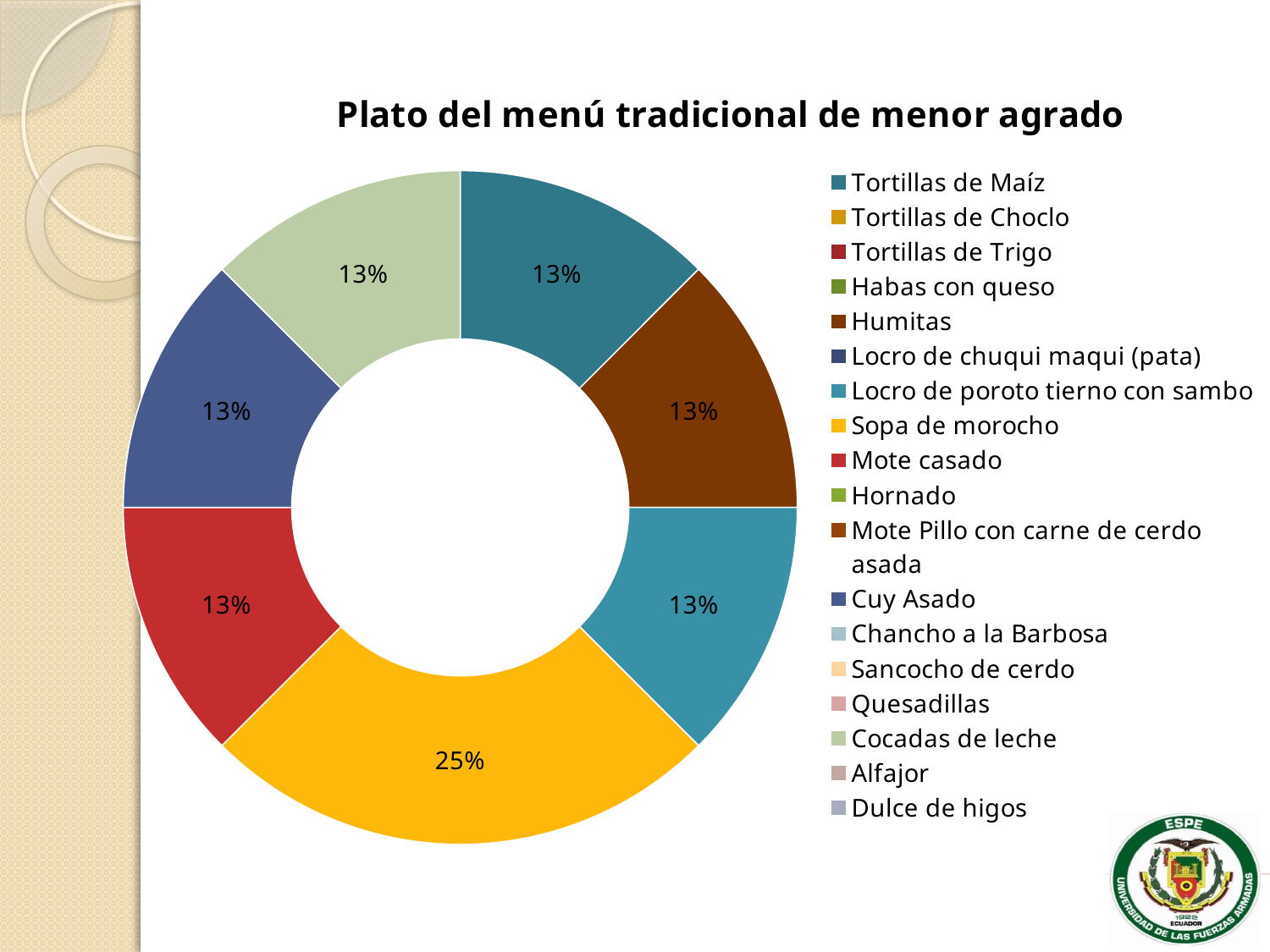
What percentage is shown for Cocadas de leche? 13% What is the title of the chart? Plato del menú tradicional de menor agrado Which dish has the largest share in the chart? Sopa de morocho Which is larger, the share for Sopa de morocho or the share for Cocadas de leche? Sopa de morocho By how many percentage points does Sopa de morocho exceed Mote casado? 12 percentage points What percentage is shown for Sopa de morocho? 25% What kind of chart is shown on the slide? Doughnut (pie) chart What share of the whole does the largest slice represent? 25% What percentage is shown for Mote casado? 13% How many slices with data labels are shown in the chart? 7 How many entries does the legend list? 18